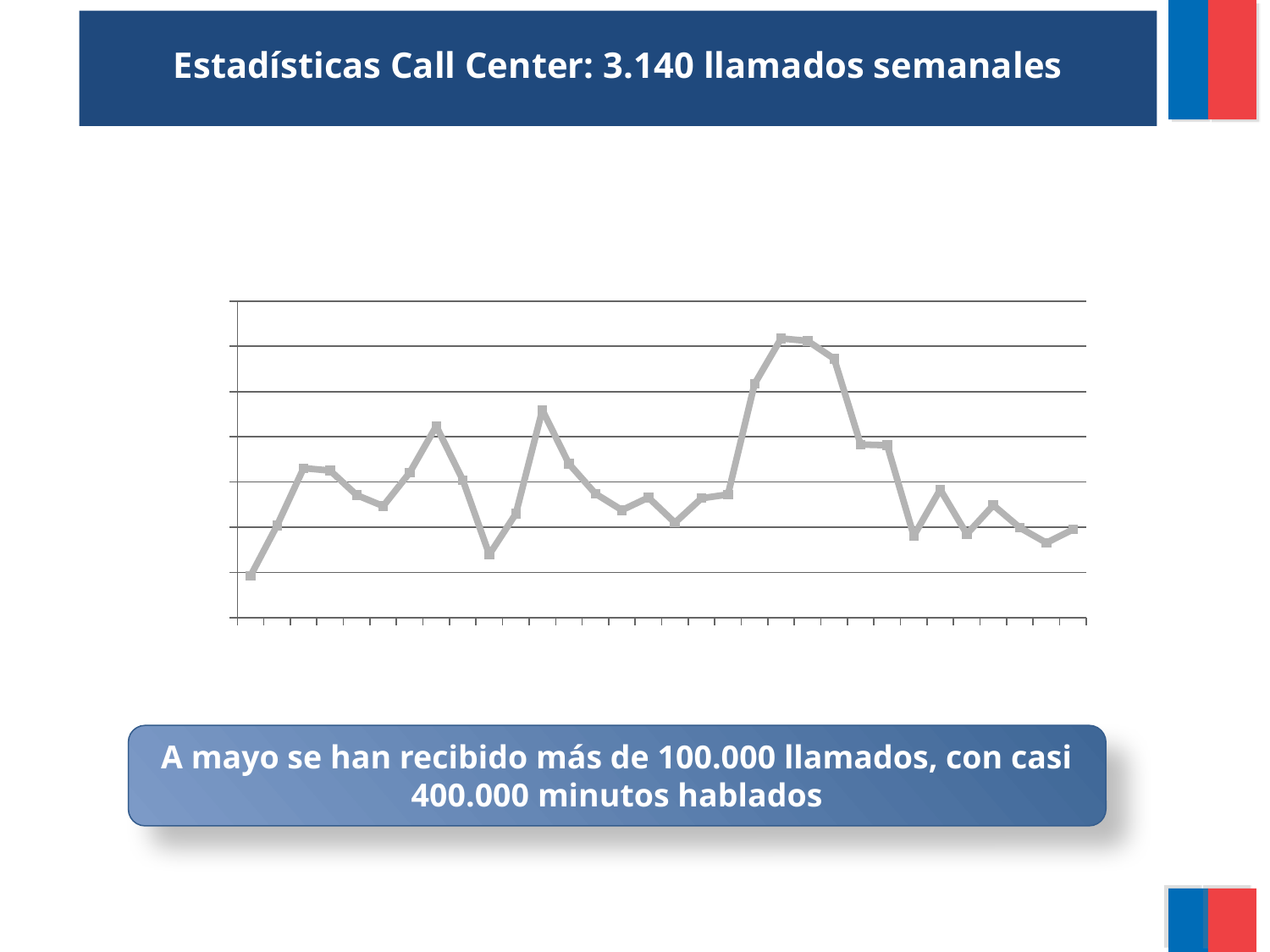
Is the lowest point of the line at the start, in the middle, or at the end of the x axis? at the start Does the line end higher or lower than where it starts at the left of the x axis? higher What kind of chart is shown on the slide? line chart Is the highest point of the line in the first half or the second half of the x axis? second half Does the chart show data labels on its points? No How many lines (series) are plotted on the chart? 1 Does the chart display a legend? No